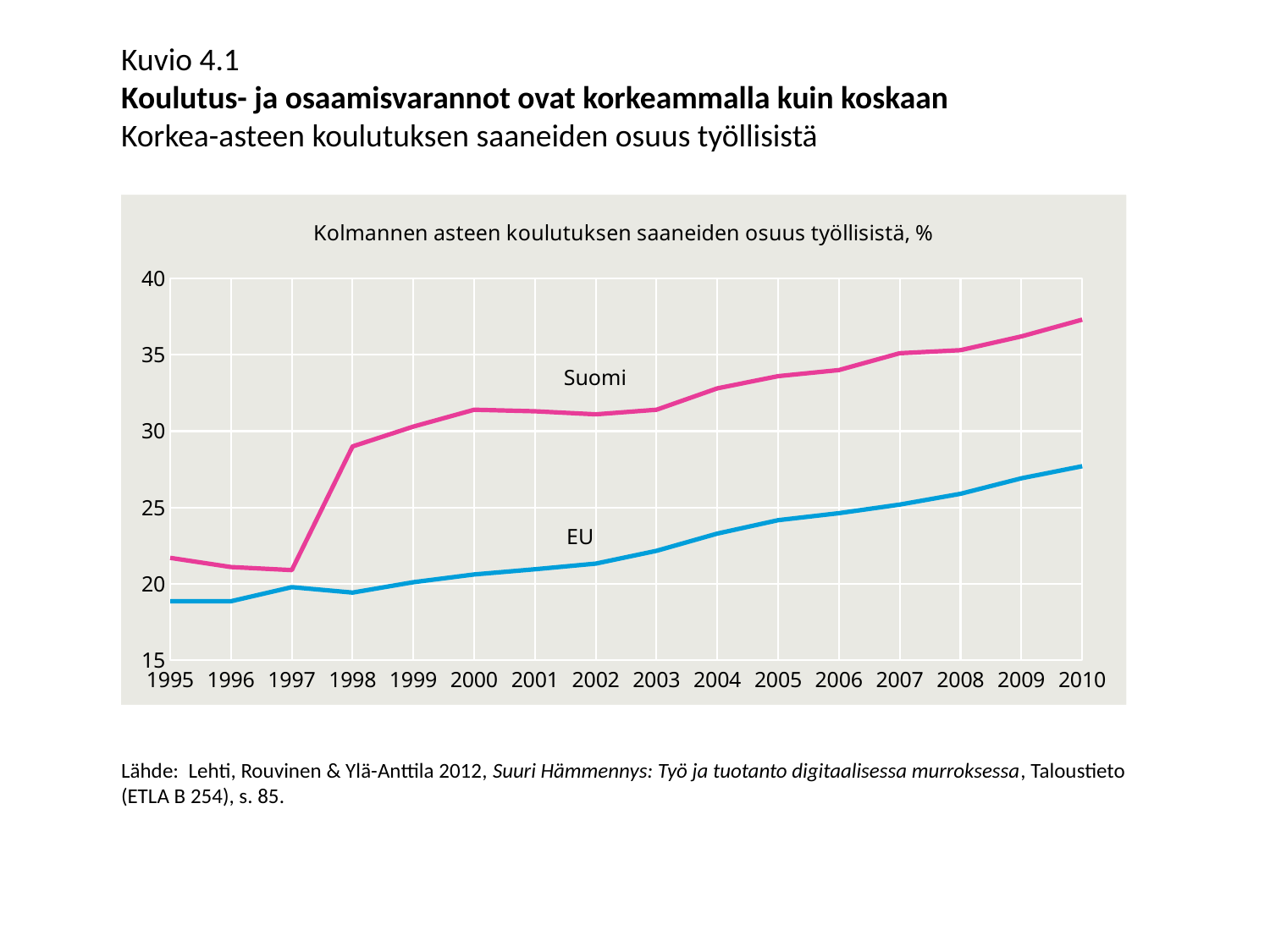
Is the value for Suomi in 2000 greater or less than 30? greater What is the title printed inside the chart area? Kolmannen asteen koulutuksen saaneiden osuus työllisistä, % How many years are shown on the x axis of the chart? 16 How many series are plotted in the chart? 2 Does the EU line rise or fall from 1997 to 2010? rise Is the value for EU in 2010 greater or less than 25? greater In which year does the Suomi line reach its highest value? 2010 Is the value for EU in 1995 greater or less than 20? less What kind of chart is shown on the slide? line chart Which series is drawn in pink? Suomi Which series has the higher value in 2010, Suomi or EU? Suomi